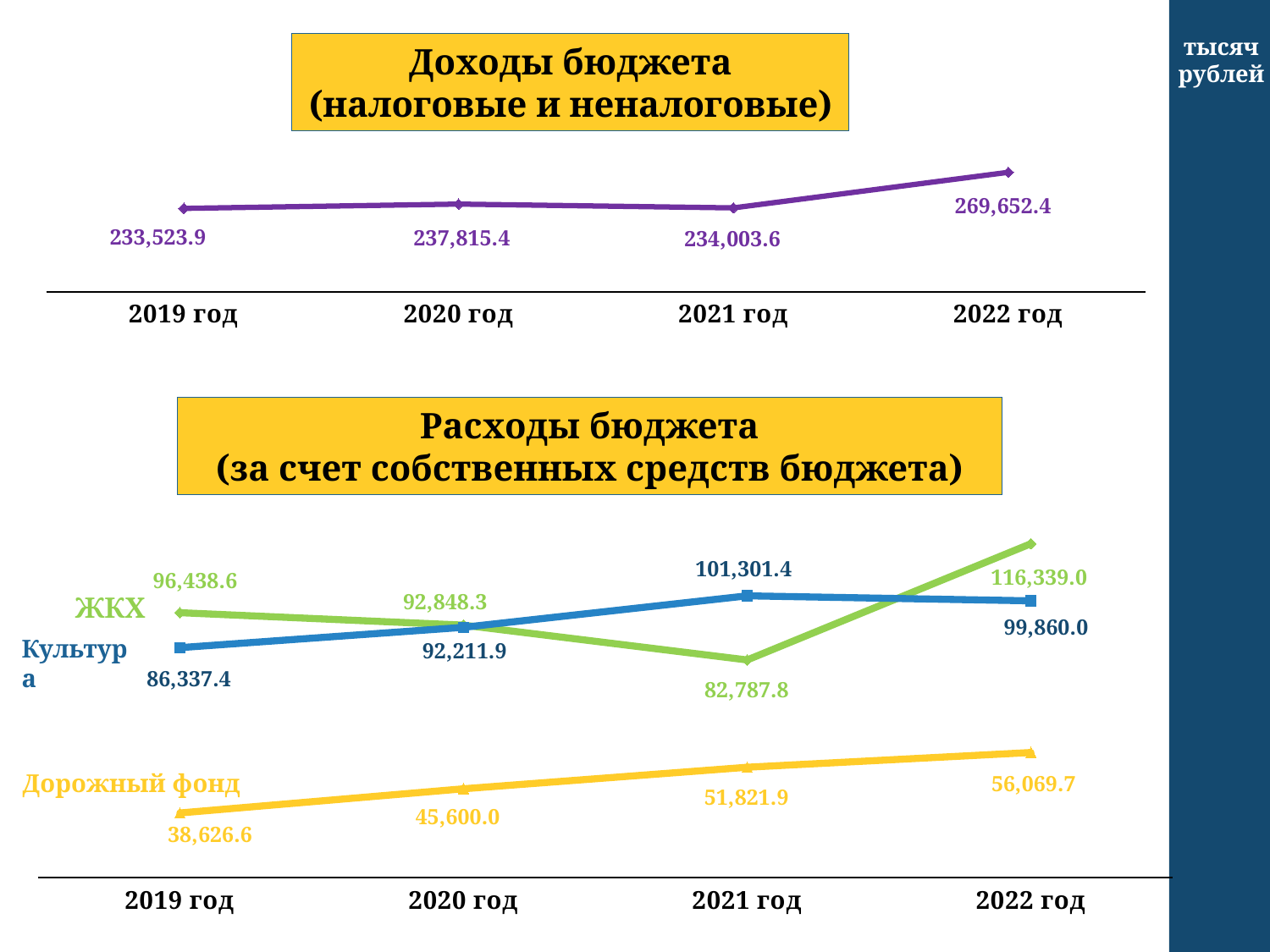
In the 'Расходы бюджета (за счет собственных средств бюджета)' chart, what is the value for Дорожный фонд in 2020 год? 45,600.0 In the 'Доходы бюджета (налоговые и неналоговые)' chart, what is the value for 2022 год? 269,652.4 In the 'Расходы бюджета (за счет собственных средств бюджета)' chart, how many series are plotted? 3 In the 'Расходы бюджета (за счет собственных средств бюджета)' chart, does the Дорожный фонд series rise or fall from 2019 год to 2022 год? Rise What kind of chart is the 'Доходы бюджета (налоговые и неналоговые)' chart? Line chart In the 'Доходы бюджета (налоговые и неналоговые)' chart, what is the value for 2019 год? 233,523.9 In the 'Расходы бюджета (за счет собственных средств бюджета)' chart, which year has the lowest value for ЖКХ? 2021 год In the 'Расходы бюджета (за счет собственных средств бюджета)' chart, which is larger in 2022 год: ЖКХ or Культура? ЖКХ In the 'Доходы бюджета (налоговые и неналоговые)' chart, what is the difference between the 2022 год and 2021 год values? 35,648.8 In the 'Доходы бюджета (налоговые и неналоговые)' chart, which year has the highest value? 2022 год In the 'Расходы бюджета (за счет собственных средств бюджета)' chart, what is the difference between the Культура values for 2021 год and 2019 год? 14,964.0 In the 'Расходы бюджета (за счет собственных средств бюджета)' chart, what is the value for ЖКХ in 2021 год? 82,787.8